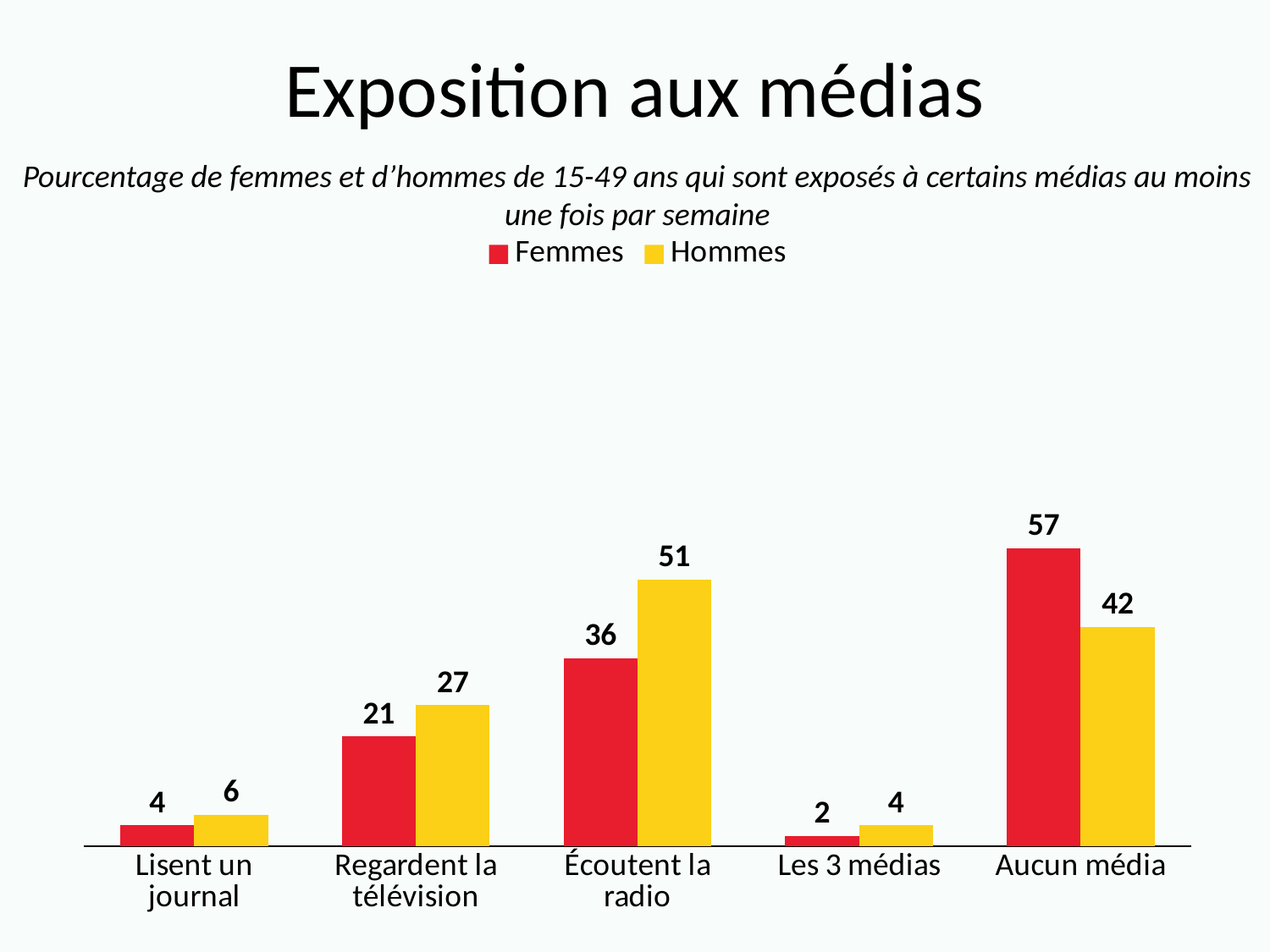
Which is larger in the Lisent un journal category, Femmes or Hommes? Hommes What is the value for Hommes in the Regardent la télévision category? 27 Which colour represents the Femmes series? Red What is the value for Femmes in the Écoutent la radio category? 36 What is the difference between Hommes and Femmes in the Écoutent la radio category? 15 How many series does the legend list? 2 What kind of chart is shown on the slide? Bar chart Which category has the highest value for Hommes? Écoutent la radio Which category has the lowest value for Femmes? Les 3 médias What is the value for Femmes in the Aucun média category? 57 How many categories are shown on the x axis? 5 What is the difference between Femmes and Hommes in the Aucun média category? 15